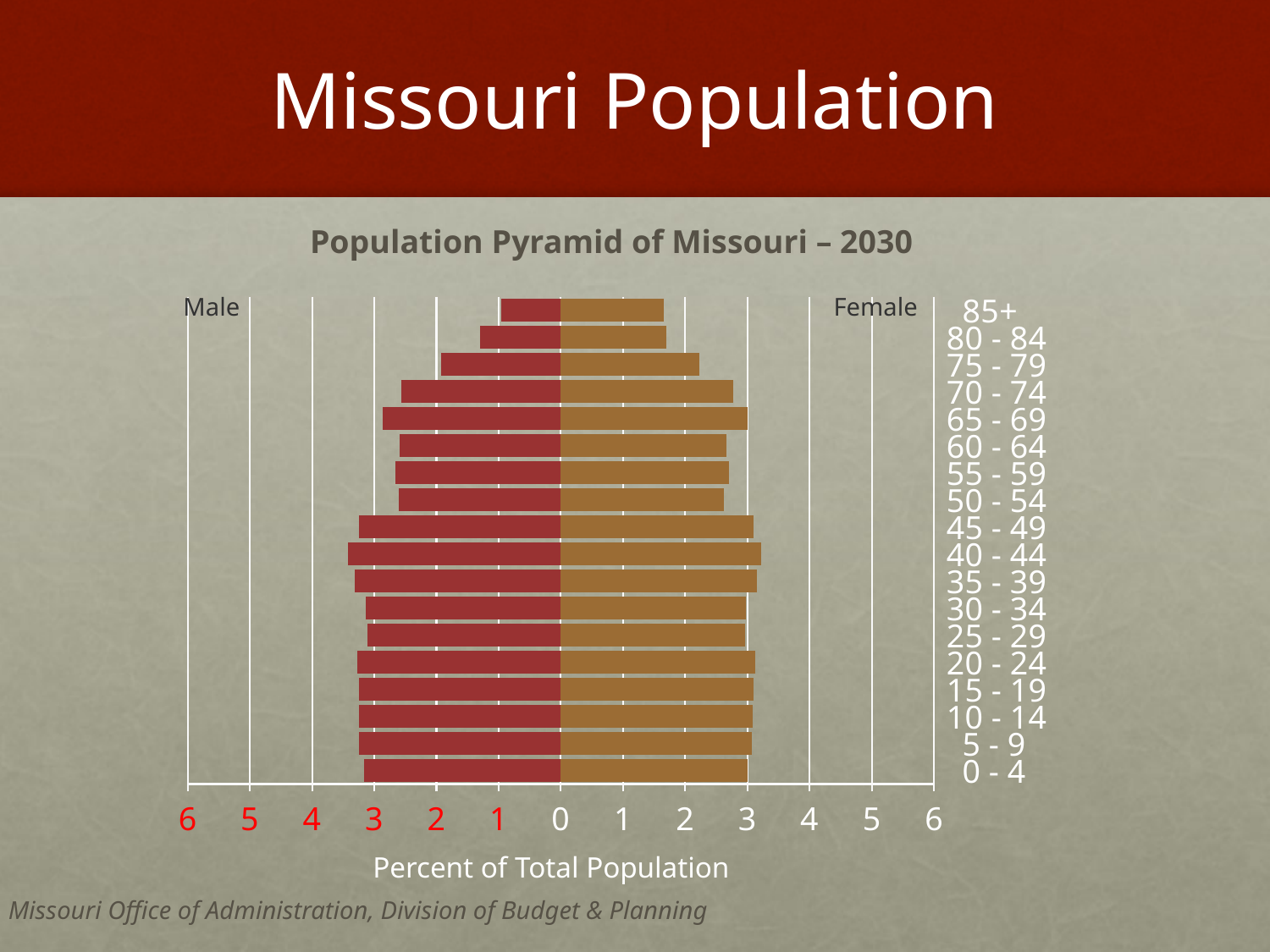
Which age group has the shortest Male bar? 85+ Is the Female value for the 85+ age group greater or less than 1? greater What is the label on the horizontal axis? Percent of Total Population For the 85+ age group, which is larger, the Male value or the Female value? Female How many series does the chart show? 2 Moving from the 65 - 69 age group up to the 85+ age group, do the Male bars get longer or shorter? shorter What kind of chart is shown on the slide? Bar chart How many age groups are shown on the population pyramid? 18 Is the Male value for the 40 - 44 age group greater or less than 3? greater Is the Male value for the 65 - 69 age group greater or less than 3? less What is the title of the chart? Population Pyramid of Missouri – 2030